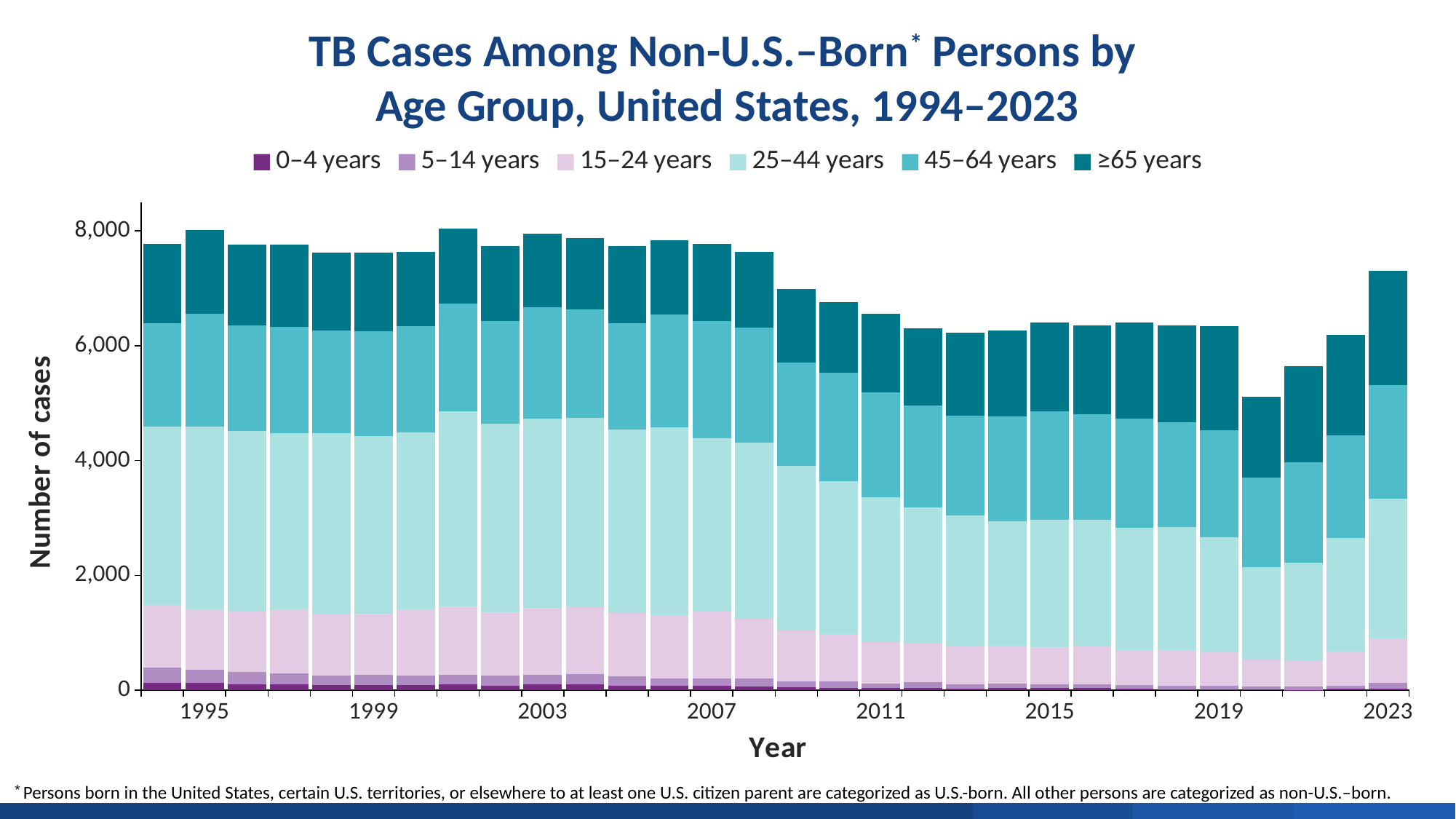
Which year has the lowest total number of TB cases among non-U.S.-born persons? 2020 How many series does the legend list? 6 Is the total number of cases for 2011 greater or less than 6,000? greater What kind of chart is shown on the slide? Stacked bar chart Do the total number of cases rise or fall from 2020 to 2023? rise Is the total number of cases for 2023 greater or less than 6,000? greater Is the total number of cases for 2020 greater or less than 6,000? less What is the label on the y axis of the chart? Number of cases Which year has the larger total number of cases, 2007 or 2019? 2007 Which age group is listed first in the legend? 0–4 years How many years (bars) are plotted in the chart? 30